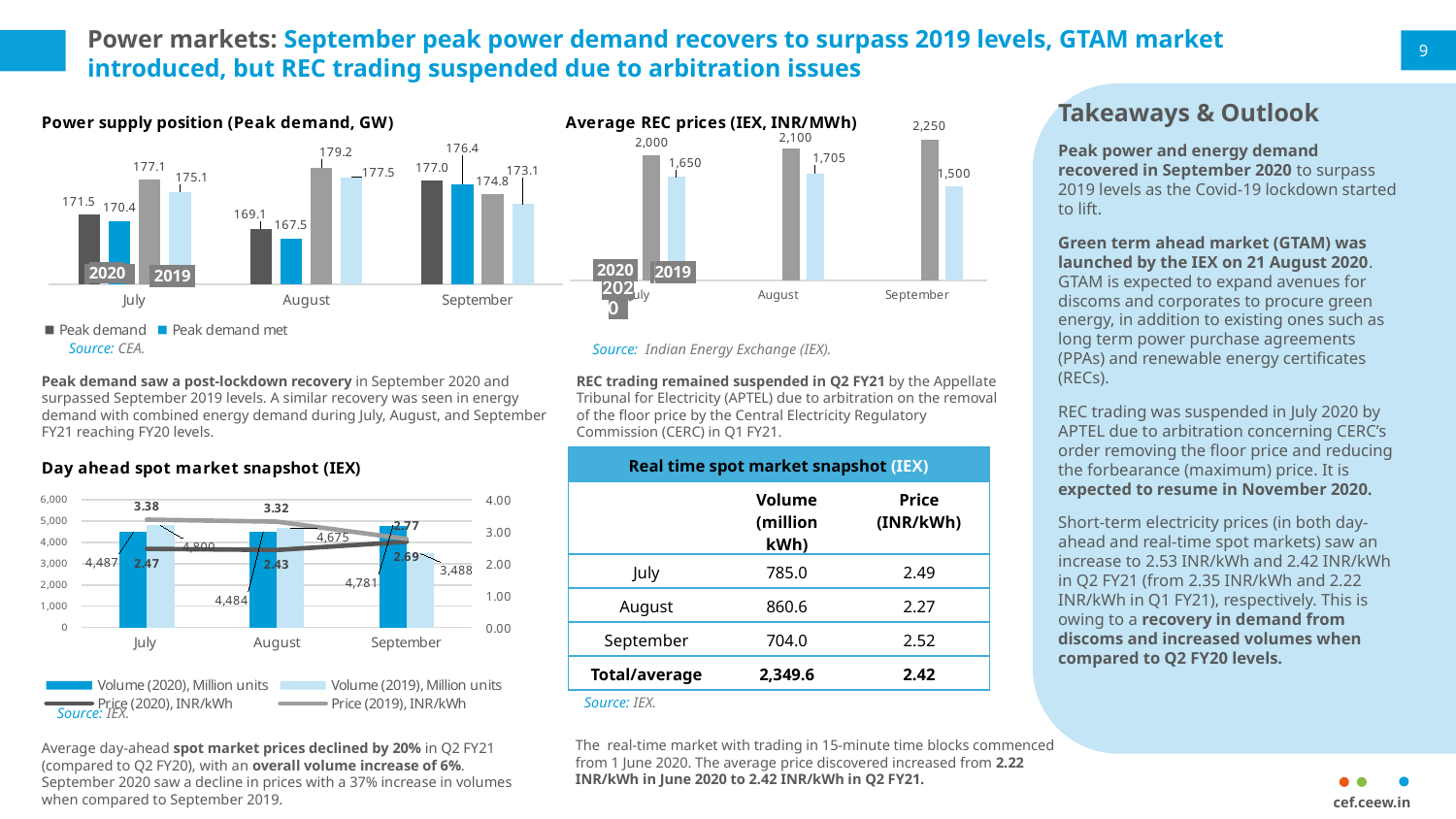
In the 'Average REC prices (IEX, INR/MWh)' chart, which month has the lowest 2019 value? September In the 'Day ahead spot market snapshot (IEX)' chart, what is the Volume (2020) for September? 4,781 In the 'Day ahead spot market snapshot (IEX)' chart, does the Price (2019) line rise or fall from July to September? Fall In the 'Average REC prices (IEX, INR/MWh)' chart, which month has the highest 2020 value? September In the 'Power supply position (Peak demand, GW)' chart, what is the 2019 peak demand met for August? 177.5 In the 'Day ahead spot market snapshot (IEX)' chart, what is the Price (2019) for July? 3.38 In the 'Average REC prices (IEX, INR/MWh)' chart, what is the difference between the 2020 and 2019 values for July? 350 In the 'Average REC prices (IEX, INR/MWh)' chart, what is the 2019 value for August? 1,705 In the 'Average REC prices (IEX, INR/MWh)' chart, what is the 2020 value for September? 2,250 In the 'Power supply position (Peak demand, GW)' chart, what is the 2020 peak demand for September? 177.0 In the 'Power supply position (Peak demand, GW)' chart, which is larger: the 2020 peak demand for August or the 2019 peak demand for August? 2019 peak demand (179.2) How many series does the legend of the 'Day ahead spot market snapshot (IEX)' chart list? 4